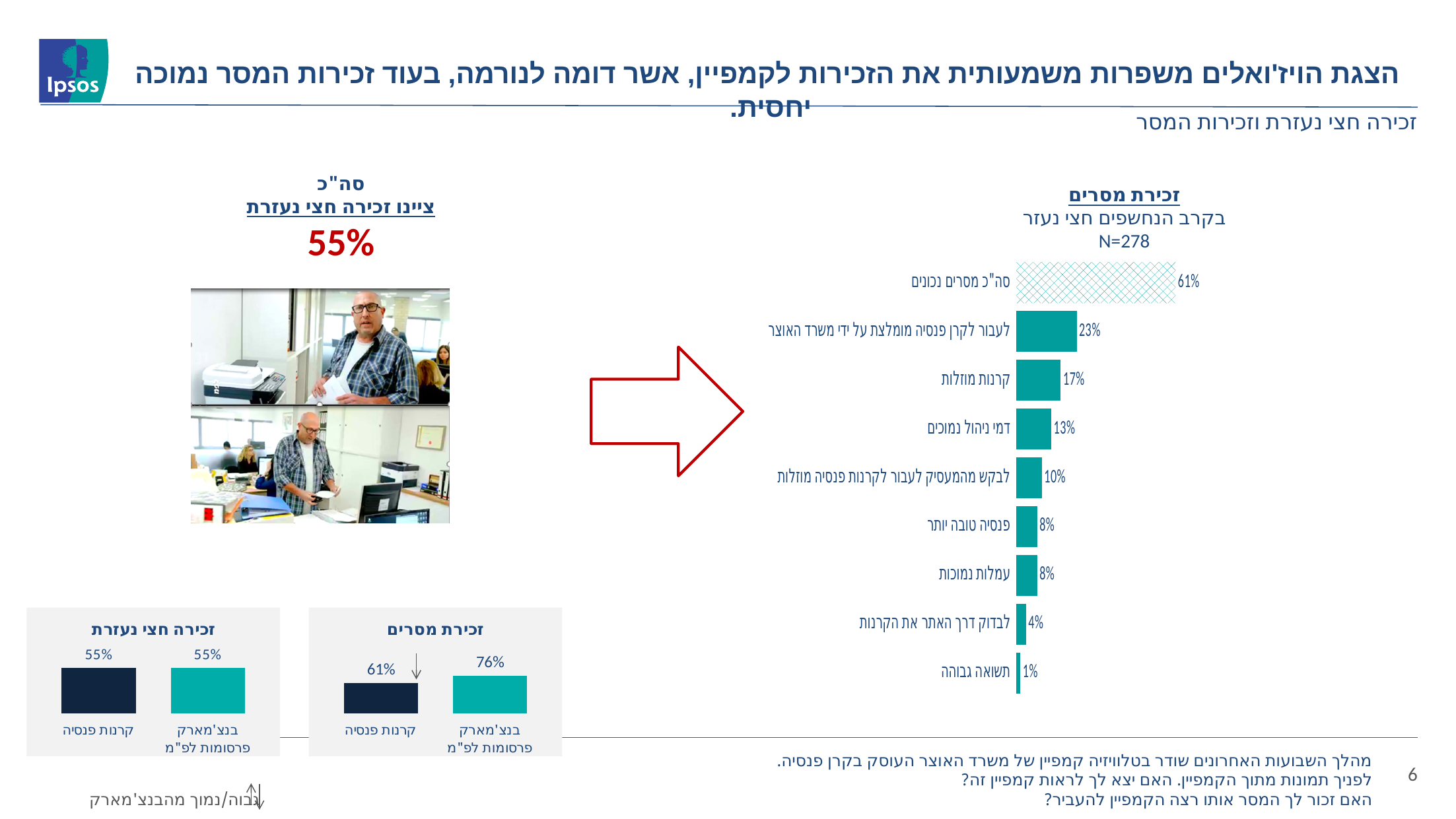
In the small 'זכירת מסרים' chart at the bottom left, what is the value for 'בנצ'מארק פרסומות לפ"מ'? 76% What is the sample size (N) shown for the 'זכירת מסרים' chart on the right? N=278 In the small 'זכירת מסרים' chart at the bottom left, what is the difference between 'בנצ'מארק פרסומות לפ"מ' and 'קרנות פנסיה'? 15% In the 'זכירת מסרים' bar chart on the right, what is the value for 'קרנות מוזלות'? 17% In the 'זכירת מסרים' bar chart on the right, which category has the lowest value? תשואה גבוהה In the 'זכירת מסרים' bar chart on the right, excluding the total bar 'סה"כ מסרים נכונים', which individual message has the highest value? לעבור לקרן פנסיה מומלצת על ידי משרד האוצר In the 'זכירת מסרים' bar chart on the right, what is the value for 'דמי ניהול נמוכים'? 13% What type of chart is the 'זכירת מסרים' chart on the right? Bar chart In the 'זכירת מסרים' bar chart on the right, what is the value for 'לבדוק דרך האתר את הקרנות'? 4% In the 'זכירת מסרים' bar chart on the right, which is larger: 'לבקש מהמעסיק לעבור לקרנות פנסיה מוזלות' or 'פנסיה טובה יותר'? לבקש מהמעסיק לעבור לקרנות פנסיה מוזלות In the 'זכירת מסרים' bar chart on the right, what is the difference between 'לעבור לקרן פנסיה מומלצת על ידי משרד האוצר' and 'קרנות מוזלות'? 6% How many categories (bars) are shown in the 'זכירת מסרים' bar chart on the right? 9